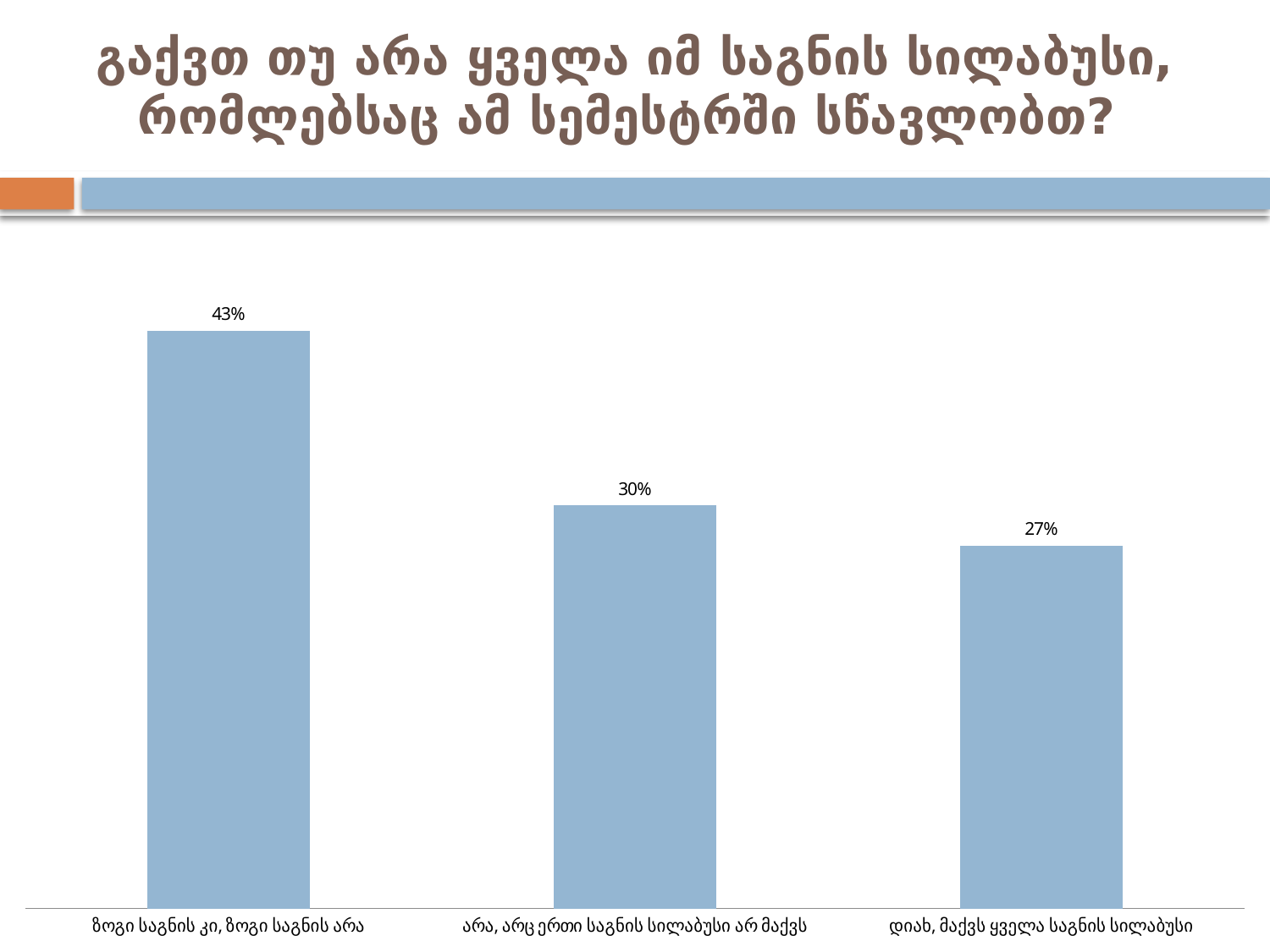
Which is larger: the value for "ზოგი საგნის კი, ზოგი საგნის არა" or the value for "არა, არც ერთი საგნის სილაბუსი არ მაქვს"? ზოგი საგნის კი, ზოგი საგნის არა What is the title of the slide containing the chart? გაქვთ თუ არა ყველა იმ საგნის სილაბუსი, რომლებსაც ამ სემესტრში სწავლობთ? What is the value for "ზოგი საგნის კი, ზოგი საგნის არა"? 43% What is the difference between the values for "ზოგი საგნის კი, ზოგი საგნის არა" and "დიახ, მაქვს ყველა საგნის სილაბუსი"? 16% Which category has the lowest value? დიახ, მაქვს ყველა საგნის სილაბუსი Which category has the highest value? ზოგი საგნის კი, ზოგი საგნის არა What is the difference between the values for "არა, არც ერთი საგნის სილაბუსი არ მაქვს" and "დიახ, მაქვს ყველა საგნის სილაბუსი"? 3% What kind of chart is shown on the slide? Bar chart What is the value for "არა, არც ერთი საგნის სილაბუსი არ მაქვს"? 30% Do the values rise or fall from left to right across the categories? Fall How many categories are shown in the chart? 3 What is the value for "დიახ, მაქვს ყველა საგნის სილაბუსი"? 27%